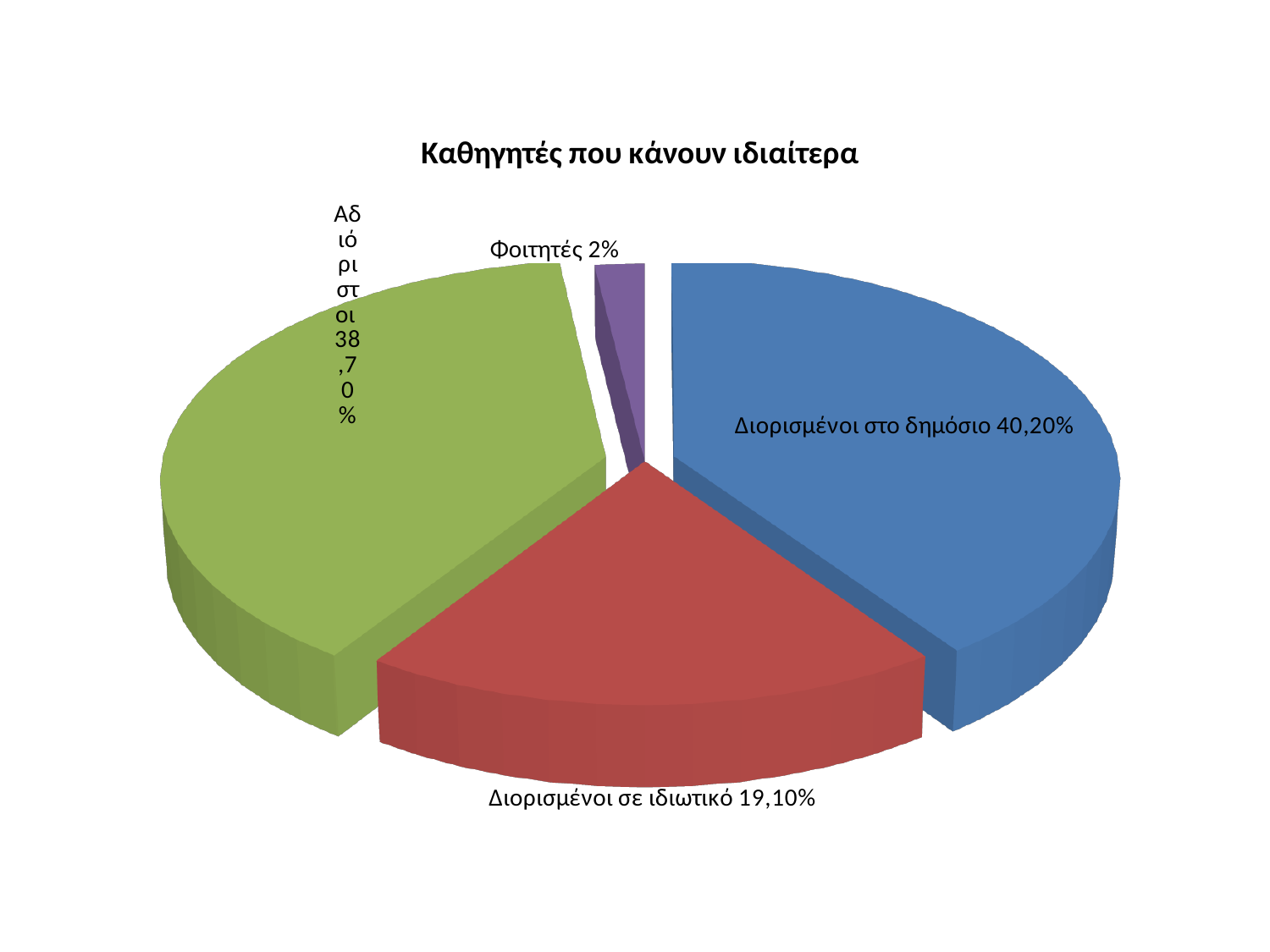
Which is larger, the share for Διορισμένοι σε ιδιωτικό or the share for Φοιτητές? Διορισμένοι σε ιδιωτικό Which category has the largest share of the pie? Διορισμένοι στο δημόσιο How many slices does the pie chart have? 4 What colour is the slice for Διορισμένοι σε ιδιωτικό? red What share of the pie is labelled Αδιόριστοι? 38,70% What is the title of the chart? Καθηγητές που κάνουν ιδιαίτερα Which category has the smallest share of the pie? Φοιτητές What share of the pie is labelled Διορισμένοι στο δημόσιο? 40,20% What share of the pie is labelled Διορισμένοι σε ιδιωτικό? 19,10% What kind of chart is shown on the slide? pie chart What is the difference between the share for Διορισμένοι στο δημόσιο and the share for Διορισμένοι σε ιδιωτικό? 21,10%